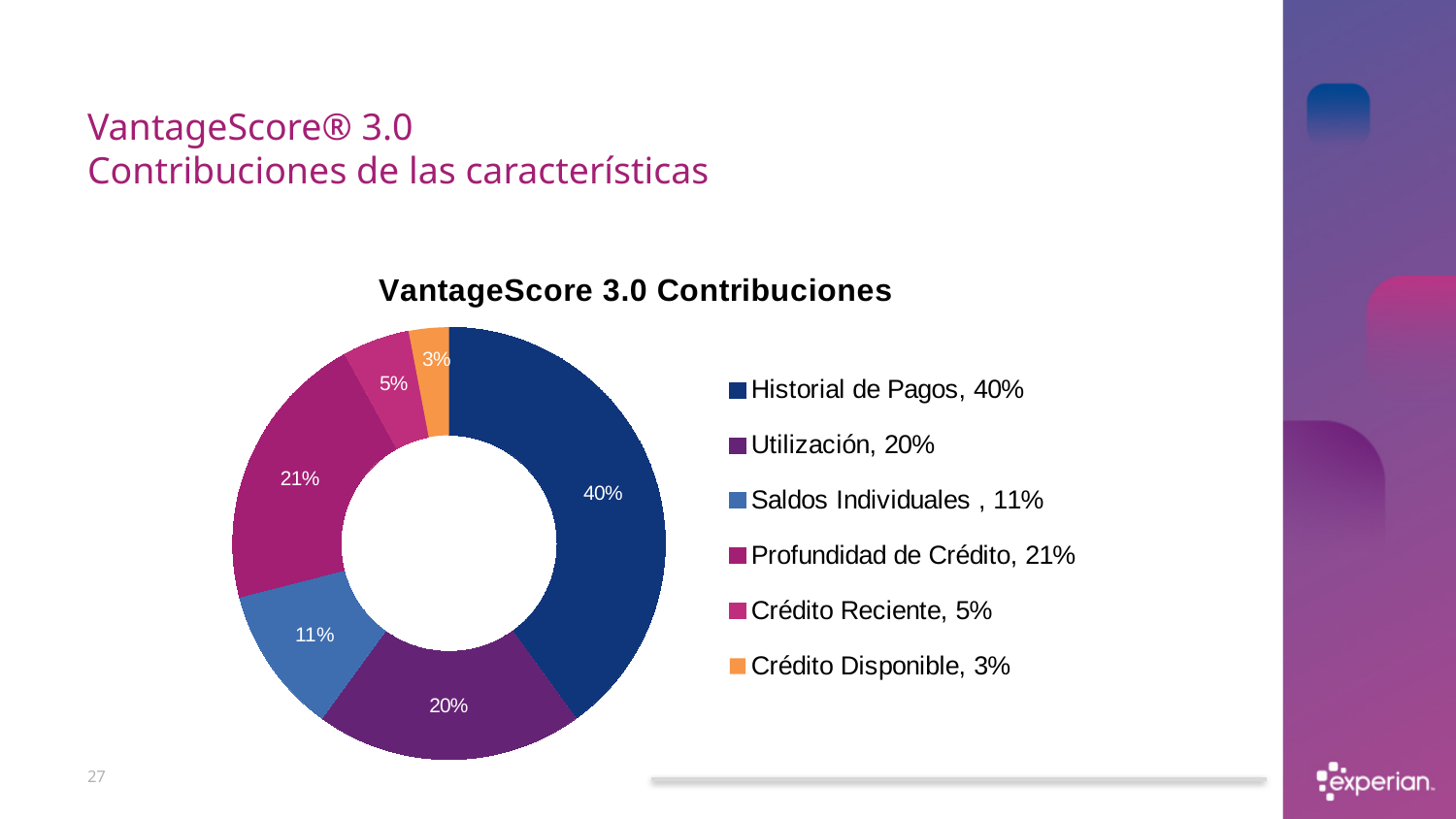
What is the value for Profundidad de Crédito in the chart? 21% What colour is the Crédito Disponible slice in the chart? Orange Which is larger, the share for Profundidad de Crédito or the share for Utilización? Profundidad de Crédito What is the value for Crédito Reciente in the chart? 5% What is the difference between the shares of Historial de Pagos and Utilización? 20% Which category has the largest share of the chart? Historial de Pagos What kind of chart is shown on the slide? Doughnut (pie) chart What is the value for Saldos Individuales in the chart? 11% What share of the VantageScore 3.0 Contribuciones chart does Historial de Pagos represent? 40% How many categories are shown in the chart? 6 Which category has the smallest share of the chart? Crédito Disponible What is the title of the chart? VantageScore 3.0 Contribuciones